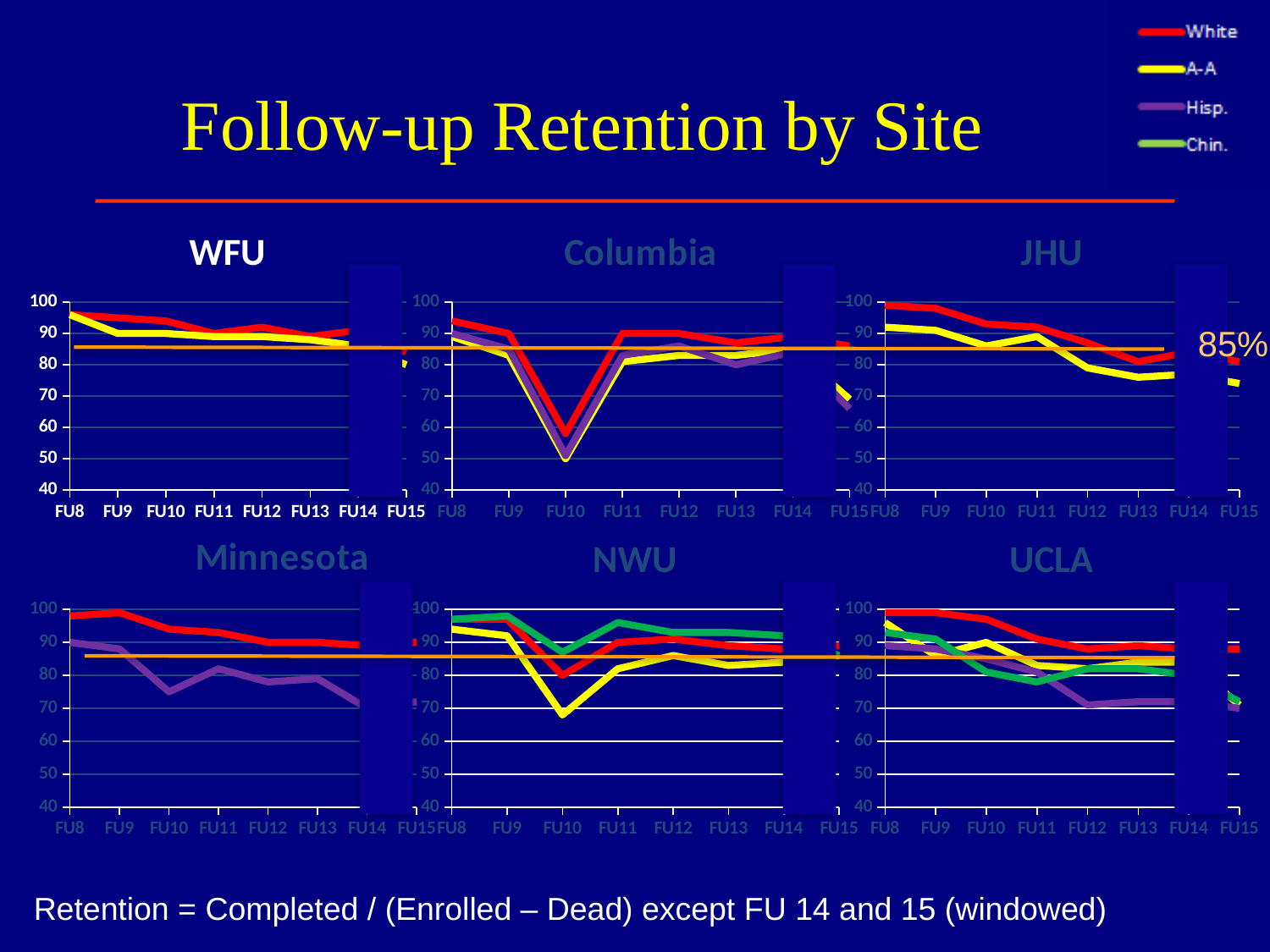
In the WFU chart, how many follow-up points are shown on the x axis? 8 In the NWU chart, is the A-A value at FU10 greater or less than 80? less In the Minnesota chart, does the White line rise or fall overall from FU8 to FU15? fall In the UCLA chart, is the Hisp. value at FU12 greater or less than 80? less How many series does the legend in the top right list? 4 In the JHU chart, is the White value at FU8 greater or less than 90? greater How many site charts are shown on the slide? 6 In the Columbia chart at FU10, which is higher, the White line or the A-A line? White What value does the horizontal reference line across the charts mark? 85% What kind of chart is used for each site on the slide? line chart